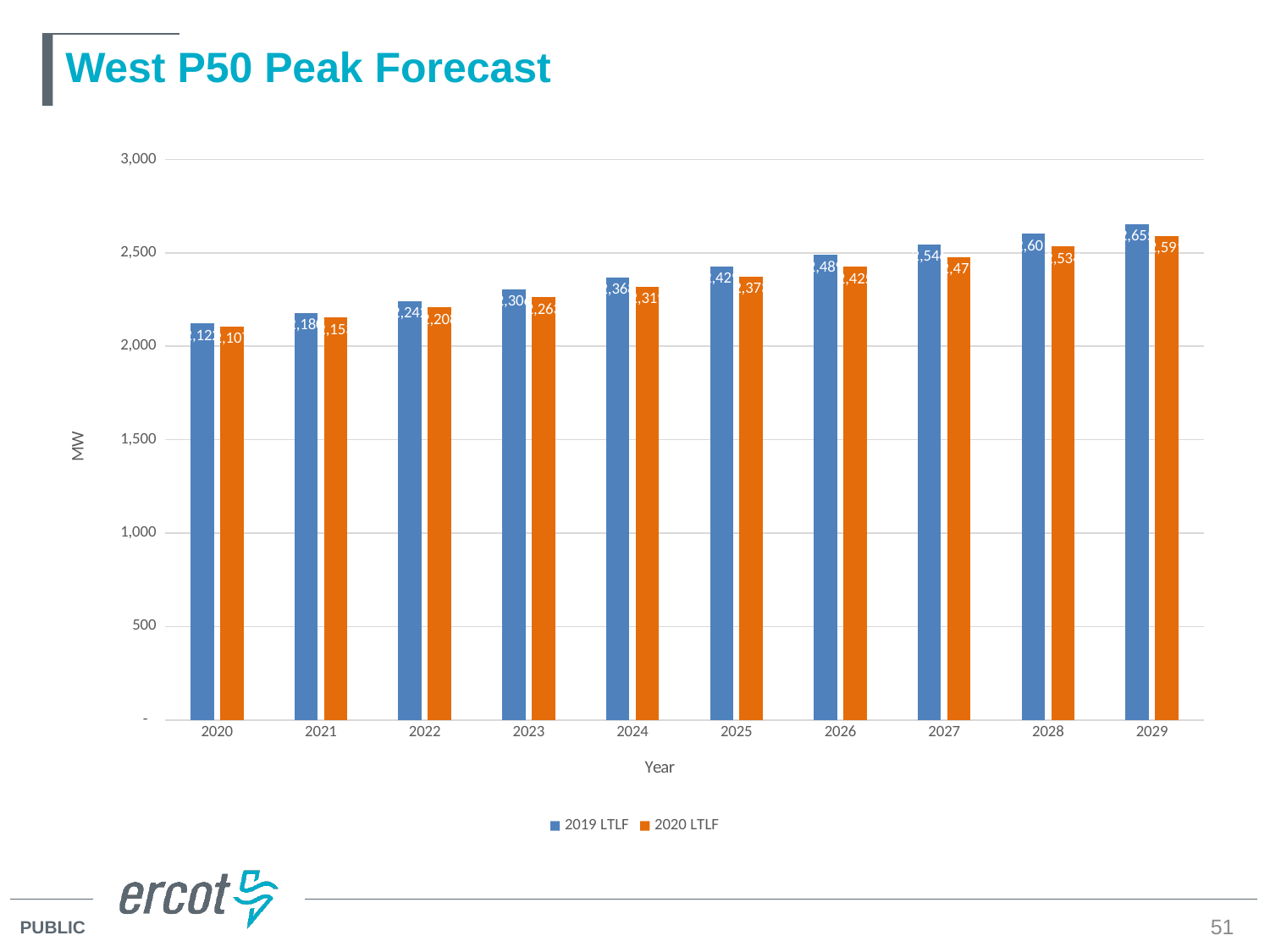
Which year has the lowest 2019 LTLF value? 2020 Is the 2019 LTLF value for 2020 greater or less than 2,000? greater Is the 2020 LTLF value for 2025 greater or less than 2,500? less In 2026, which series has the larger value, 2019 LTLF or 2020 LTLF? 2019 LTLF What are the two series named in the legend? 2019 LTLF and 2020 LTLF What kind of chart is shown on the slide? bar chart How many series does the legend list? 2 Do the 2019 LTLF values rise or fall from 2020 to 2029? rise Is the 2019 LTLF value for 2029 greater or less than 2,500? greater How many years are shown on the x axis? 10 What is the label of the y axis? MW Which year has the highest 2020 LTLF value? 2029